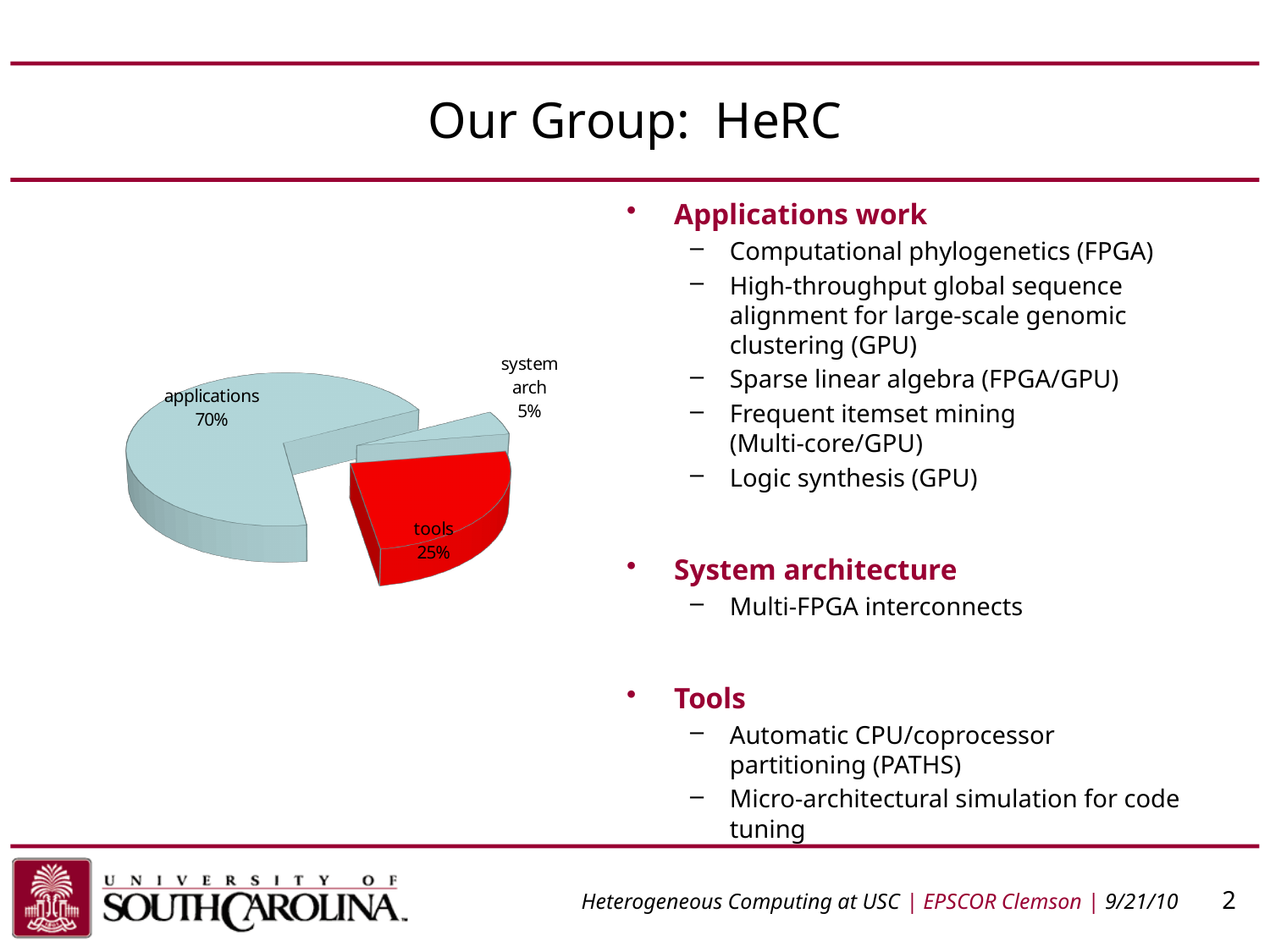
What is the difference in percentage points between the tools slice and the system arch slice? 20 What share of the pie does the system arch slice represent? 5% What kind of chart is shown on the slide? pie chart What share of the pie does the tools slice represent? 25% What share of the pie does the applications slice represent? 70% How many slices does the pie chart have? 3 Which slice of the pie chart is the largest? applications Which slice of the pie chart is the smallest? system arch Which slice of the pie chart is coloured red? tools What is the difference in percentage points between the applications slice and the tools slice? 45 Which is larger, the tools slice or the system arch slice? tools What is the combined share of the tools and system arch slices? 30%